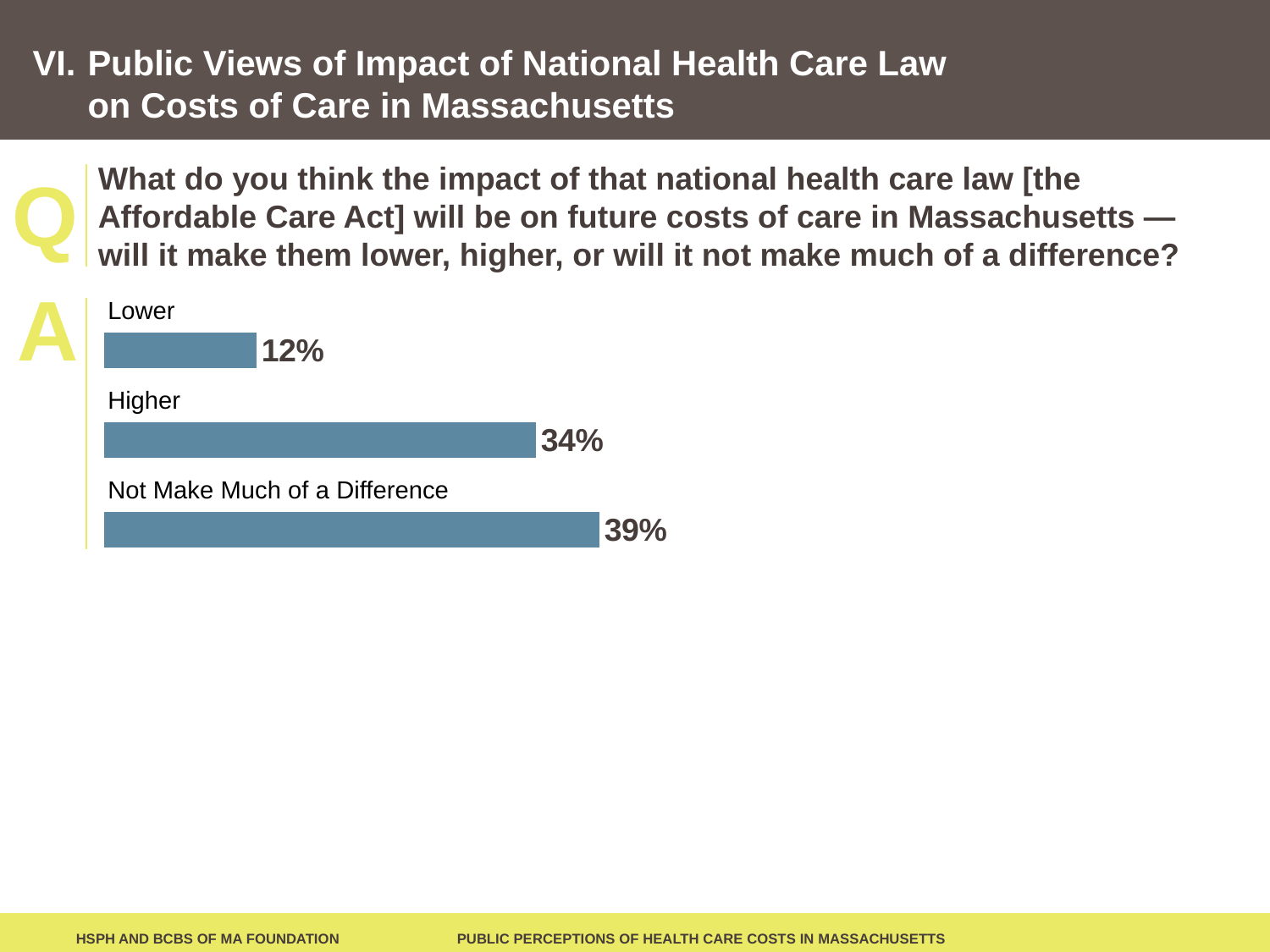
What is the difference in percentage points between 'Higher' and 'Lower'? 22 What kind of chart is shown on the slide? Bar chart What percentage of respondents said the national health care law will make costs of care in Massachusetts lower? 12% What is the difference in percentage points between 'Not Make Much of a Difference' and 'Higher'? 5 What colour are the bars in the chart? Blue Which is larger, the percentage for 'Higher' or the percentage for 'Lower'? Higher What is the combined percentage of respondents who said 'Lower' or 'Higher'? 46% Which response category has the lowest percentage? Lower Which response category has the highest percentage? Not Make Much of a Difference How many response categories are shown in the chart? 3 What percentage of respondents said the national health care law will make costs of care higher? 34% What percentage of respondents said the law will not make much of a difference to costs of care? 39%